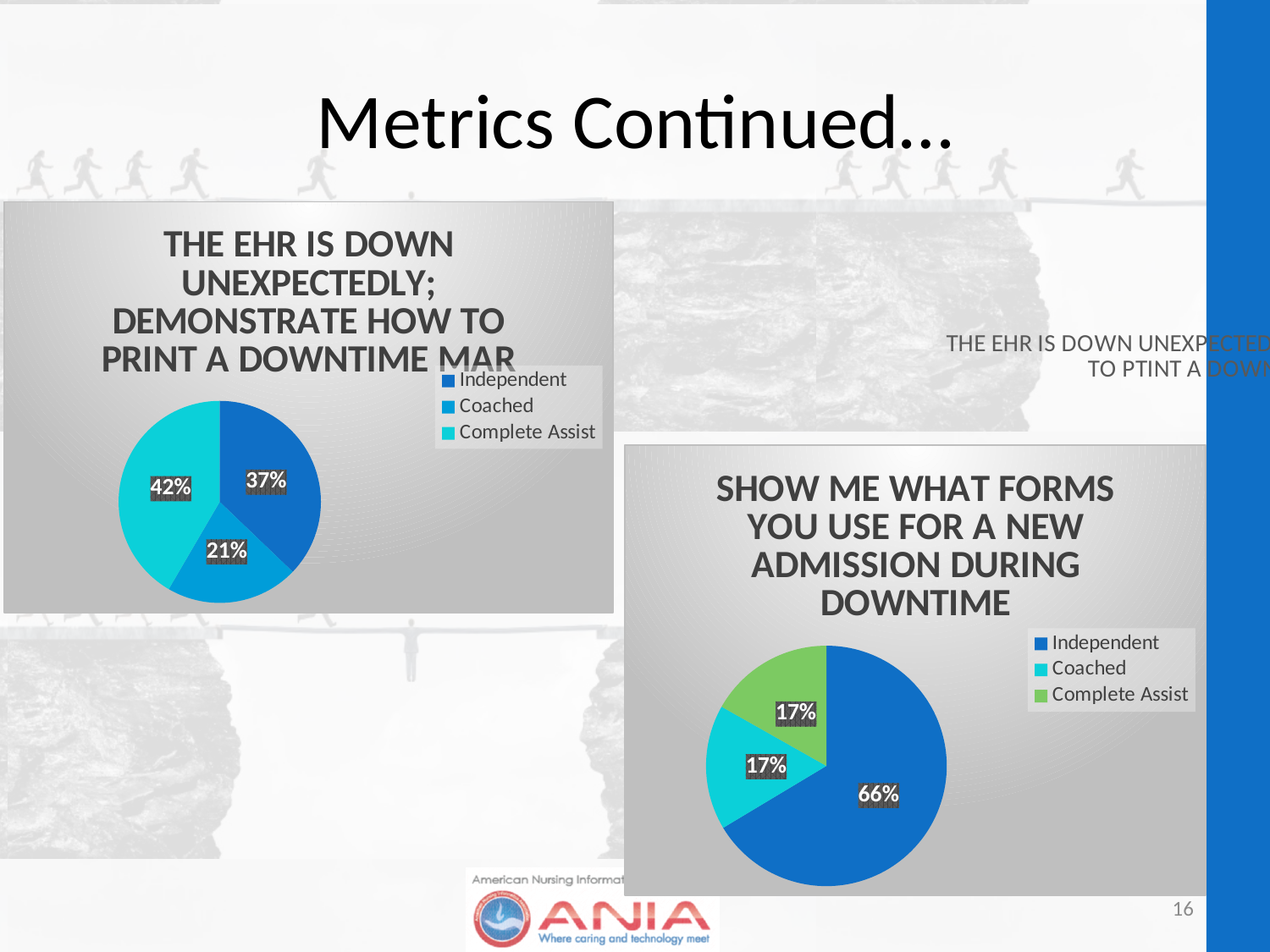
In the chart titled 'The EHR is down unexpectedly; demonstrate how to print a downtime MAR', which category has the smallest share? Coached In the chart titled 'The EHR is down unexpectedly; demonstrate how to print a downtime MAR', what share is Independent? 37% In the chart titled 'The EHR is down unexpectedly; demonstrate how to print a downtime MAR', which category has the largest share? Complete Assist In the chart titled 'The EHR is down unexpectedly; demonstrate how to print a downtime MAR', what share is Complete Assist? 42% What type of chart is used for 'Show me what forms you use for a new admission during downtime'? Pie chart In the chart titled 'The EHR is down unexpectedly; demonstrate how to print a downtime MAR', what is the difference between the Complete Assist and Independent shares? 5% In the chart titled 'Show me what forms you use for a new admission during downtime', what is the difference between the Independent and Complete Assist shares? 49% In the chart titled 'Show me what forms you use for a new admission during downtime', which category has the largest share? Independent In the chart titled 'The EHR is down unexpectedly; demonstrate how to print a downtime MAR', what share is Coached? 21% How many categories does the legend list in the chart titled 'Show me what forms you use for a new admission during downtime'? 3 In the chart titled 'Show me what forms you use for a new admission during downtime', what share is Coached? 17% In the chart titled 'Show me what forms you use for a new admission during downtime', what share is Independent? 66%